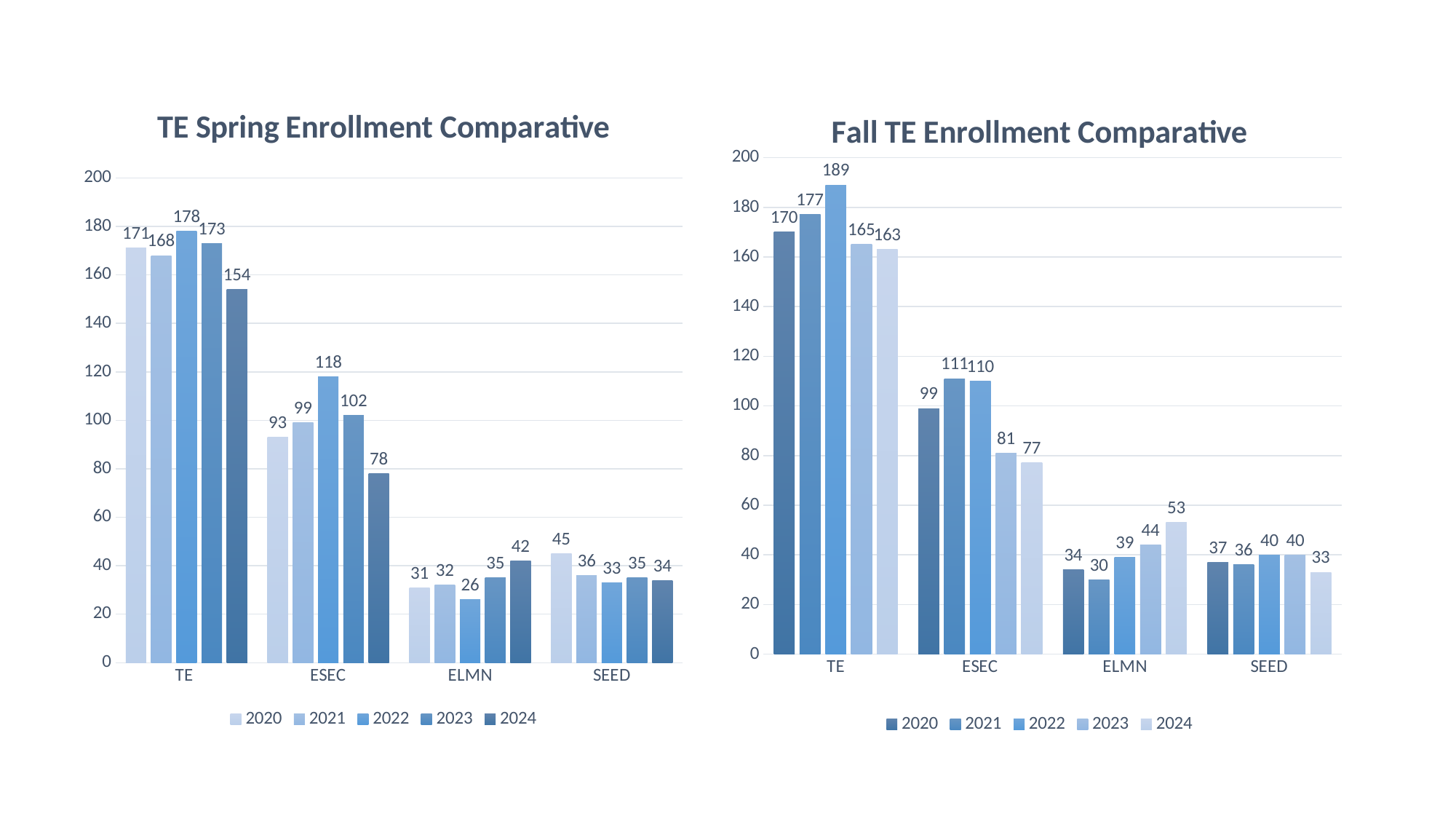
In the 'Fall TE Enrollment Comparative' chart, what is the value for ESEC in 2022? 110 In the 'Fall TE Enrollment Comparative' chart, which is larger for TE: the 2021 value or the 2023 value? 2021 In the 'TE Spring Enrollment Comparative' chart, is the value for ESEC in 2024 greater or less than 80? less In the 'TE Spring Enrollment Comparative' chart, what is the value for TE in 2024? 154 How many series does the legend of the 'TE Spring Enrollment Comparative' chart list? 5 In the 'Fall TE Enrollment Comparative' chart, which year has the lowest value for SEED? 2024 In the 'Fall TE Enrollment Comparative' chart, do the ELMN values rise or fall from 2021 to 2024? Rise How many categories are shown on the x axis of the 'Fall TE Enrollment Comparative' chart? 4 In the 'TE Spring Enrollment Comparative' chart, which year has the highest value for ESEC? 2022 What kind of chart is the 'Fall TE Enrollment Comparative' chart? Bar chart In the 'Fall TE Enrollment Comparative' chart, what is the difference between the 2020 and 2024 values for ELMN? 19 In the 'TE Spring Enrollment Comparative' chart, what is the difference between the 2022 and 2024 values for TE? 24